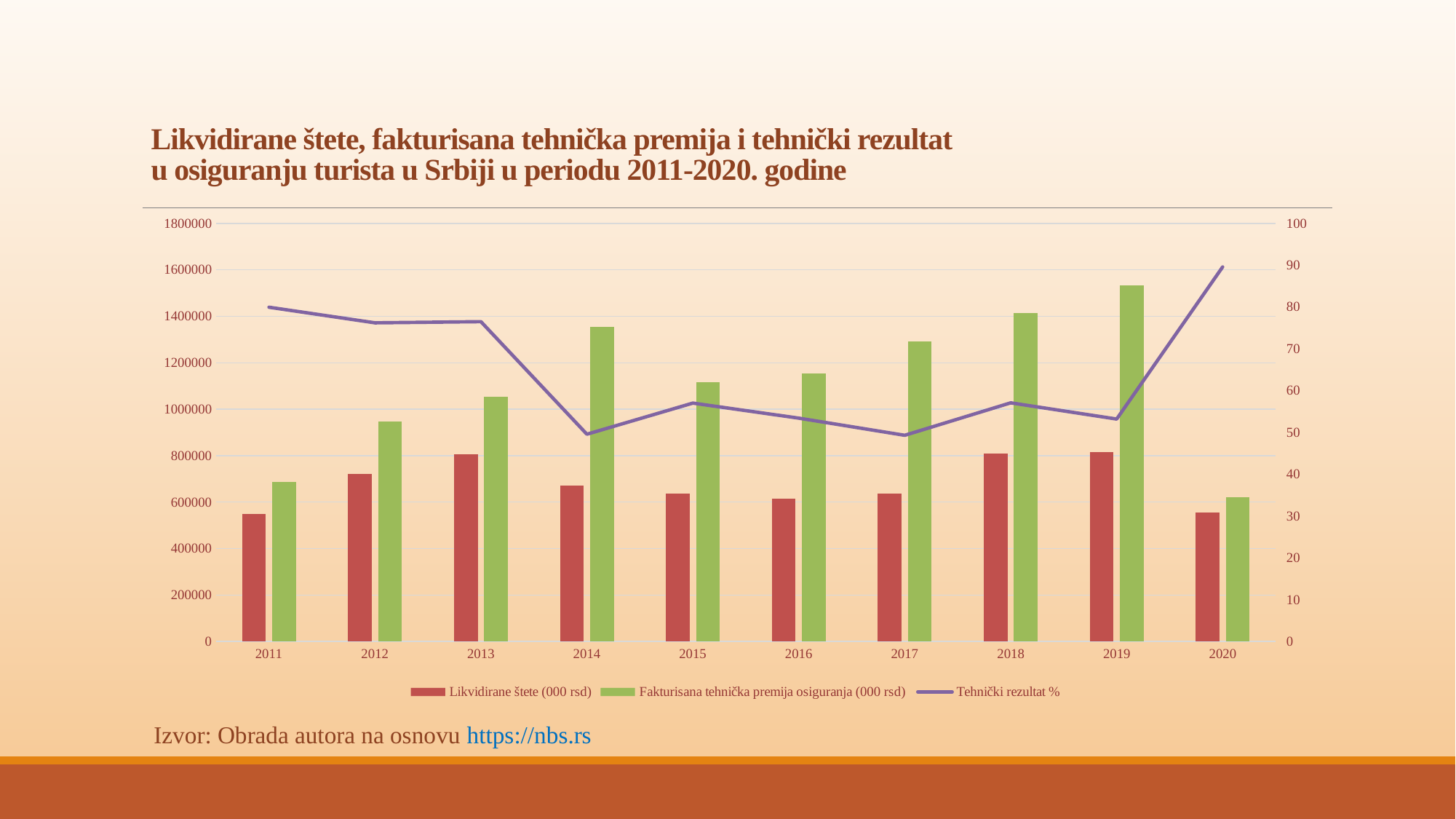
In which year is Tehnički rezultat % the highest? 2020 Is the value of Tehnički rezultat % for 2011 greater or less than 70? greater Is the value of Likvidirane štete (000 rsd) for 2011 greater or less than 600000? less How many years are shown on the x axis? 10 What kind of chart is shown on the slide? A combined bar and line chart In which year is Fakturisana tehnička premija osiguranja (000 rsd) the highest? 2019 Does Fakturisana tehnička premija osiguranja (000 rsd) rise or fall from 2015 to 2019? rise Is the value of Fakturisana tehnička premija osiguranja (000 rsd) for 2014 greater or less than 1200000? greater Which year has the larger Fakturisana tehnička premija osiguranja (000 rsd), 2017 or 2018? 2018 In which year is Fakturisana tehnička premija osiguranja (000 rsd) the lowest? 2020 Which series is plotted as a line rather than bars? Tehnički rezultat % How many series does the legend list? 3